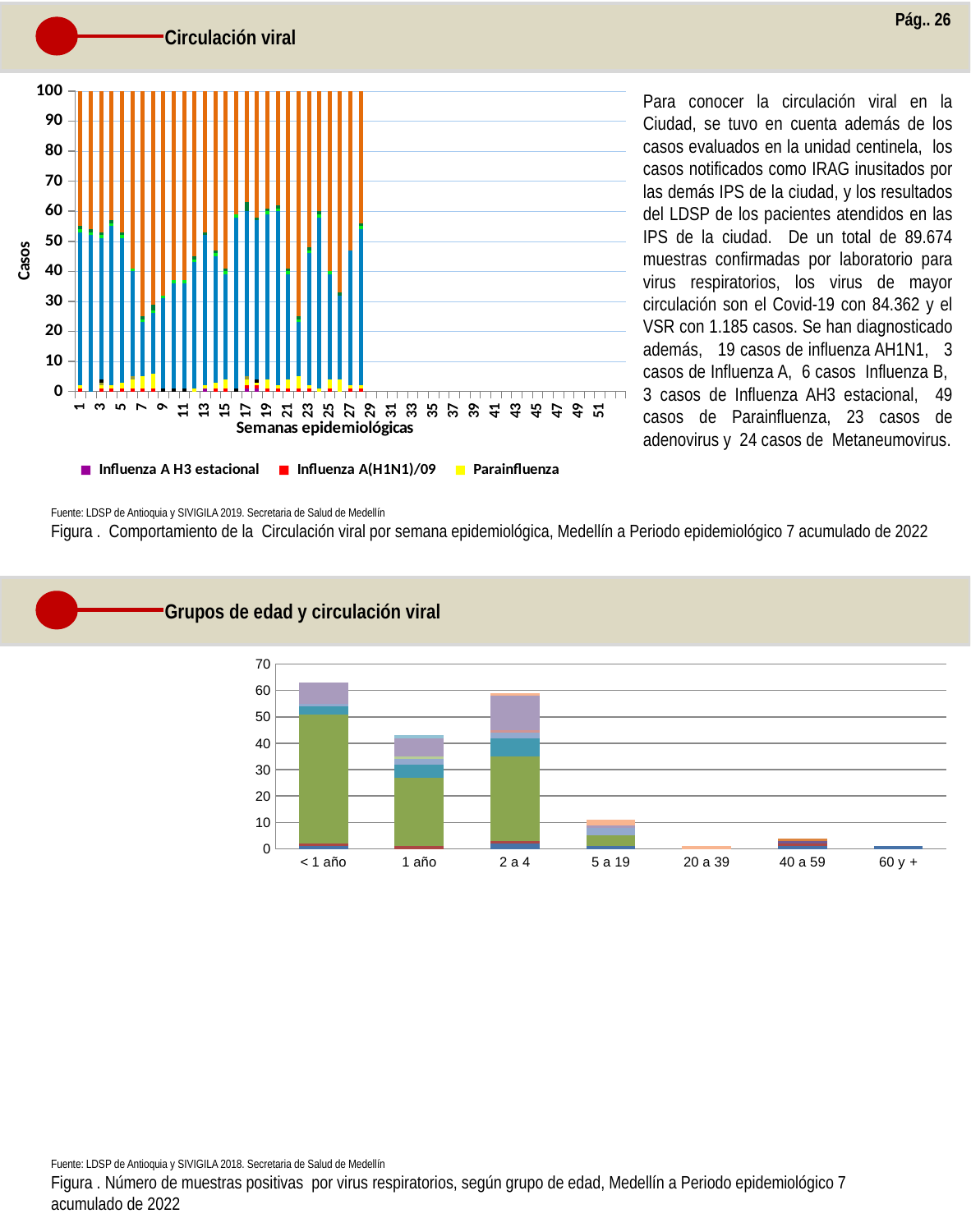
In the bottom chart (by age group), which has the taller bar, '< 1 año' or '1 año'? < 1 año In the top chart (by semana epidemiológica), how many series does the legend list? 3 What kind of chart is the top chart (Circulación viral by semana epidemiológica)? Stacked bar chart In the bottom chart (by age group), how many age-group categories are shown on the x axis? 7 In the bottom chart (by age group), is the total for '5 a 19' greater or less than 20? less What kind of chart is the bottom chart (muestras positivas por grupo de edad)? Stacked bar chart In the bottom chart (by age group), is the total for '2 a 4' greater or less than 50? greater In the top chart (by semana epidemiológica), what is the label of the x axis? Semanas epidemiológicas In the bottom chart (by age group), which has the taller bar, '2 a 4' or '5 a 19'? 2 a 4 In the top chart (by semana epidemiológica), what is the label of the y axis? Casos In the bottom chart (by age group), is the total for '< 1 año' greater or less than 60? greater